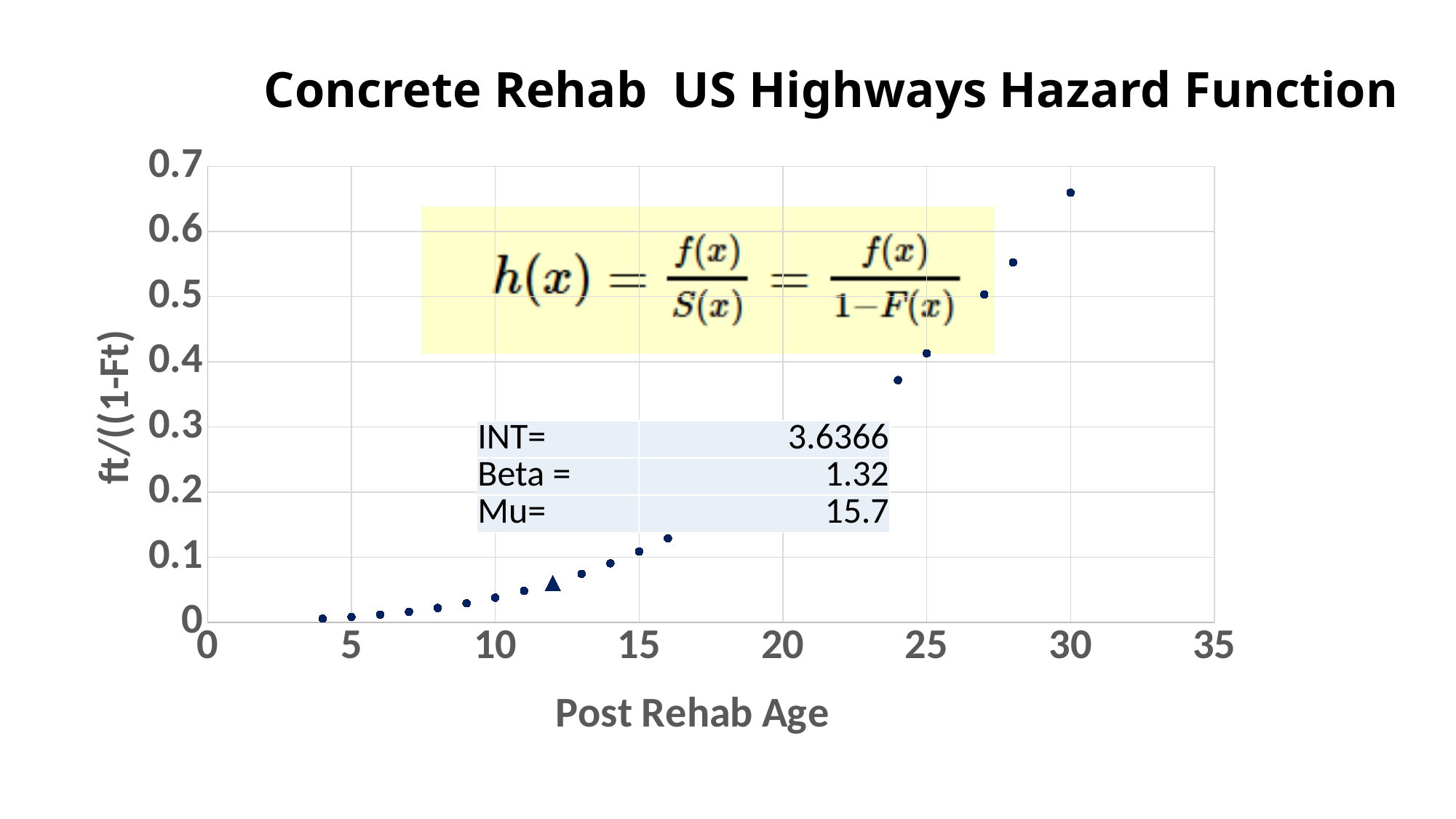
Which has the larger plotted value, Post Rehab Age 25 or Post Rehab Age 15? Post Rehab Age 25 Is the value at Post Rehab Age 24 greater or less than 0.4? less Is the value at Post Rehab Age 16 greater or less than 0.1? greater What kind of chart is shown on the slide? scatter chart Is the value at Post Rehab Age 28 greater or less than 0.5? greater What value is given for Beta in the text box on the chart? 1.32 At which Post Rehab Age is the plotted value highest? 30 Which has the larger plotted value, Post Rehab Age 8 or Post Rehab Age 14? Post Rehab Age 14 What is the title of the chart? Concrete Rehab US Highways Hazard Function Do the plotted values rise or fall as Post Rehab Age increases? rise